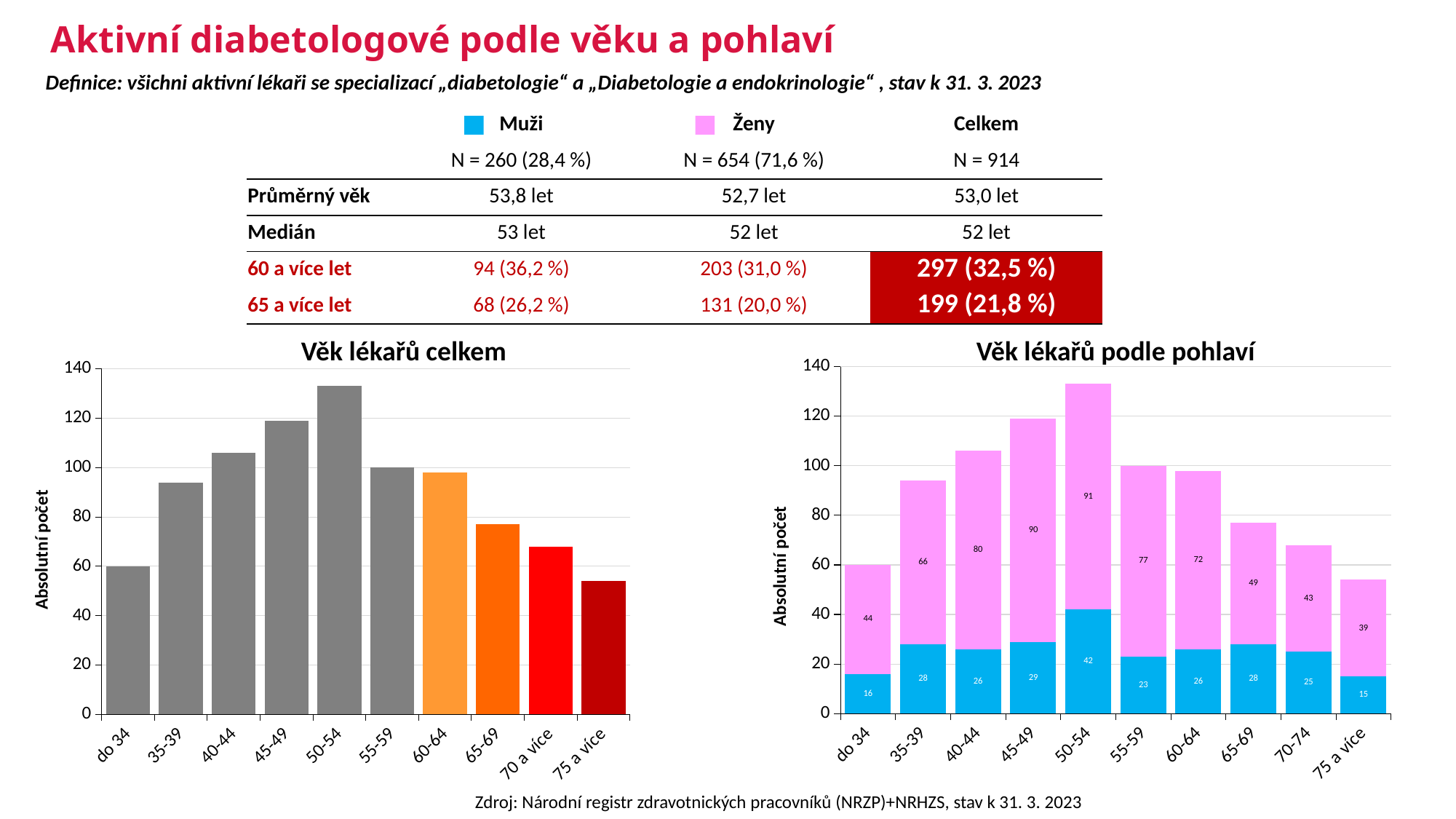
In the chart 'Věk lékařů podle pohlaví', what is the value for Ženy in the 45-49 age group? 90 In the chart 'Věk lékařů podle pohlaví', what is the value for Muži in the 50-54 age group? 42 In the chart 'Věk lékařů podle pohlaví', how much larger is the Ženy value than the Muži value in the 40-44 age group? 54 What kind of chart is 'Věk lékařů celkem'? bar chart In the chart 'Věk lékařů podle pohlaví', which age group has the lowest value for Muži? 75 a více In the chart 'Věk lékařů celkem', which age group has the highest bar? 50-54 In the chart 'Věk lékařů podle pohlaví', what is the total of the stacked bar for the 35-39 age group? 94 In the chart 'Věk lékařů podle pohlaví', which age group has the highest value for Ženy? 50-54 In the chart 'Věk lékařů celkem', which age group has the lowest bar? 75 a více In the chart 'Věk lékařů celkem', is the value for 45-49 greater or less than 100? greater How many series does the chart 'Věk lékařů podle pohlaví' show? 2 How many age groups are shown on the x axis of the chart 'Věk lékařů celkem'? 10